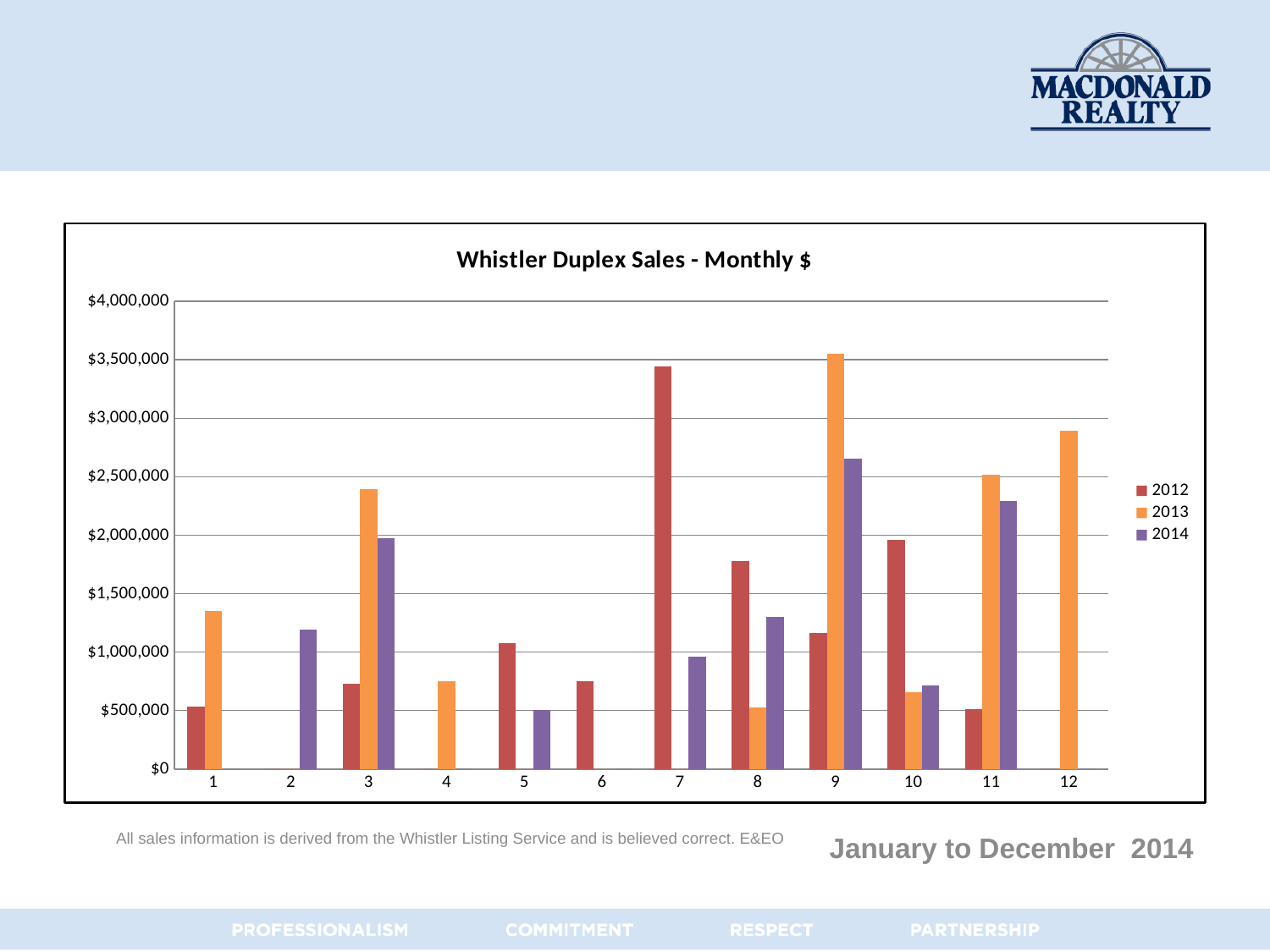
What is the title of the chart? Whistler Duplex Sales - Monthly $ Is the 2013 value for month 12 greater or less than $3,000,000? less How many months (categories) are shown on the x axis? 12 How many series does the legend list? 3 In month 3, which series has the larger value, 2013 or 2014? 2013 What kind of chart is shown on the slide? bar chart In month 9, which series has the larger value, 2012 or 2013? 2013 In which month does the 2014 series reach its highest value? 9 In which month does the 2012 series reach its highest value? 7 Is the 2012 value for month 7 greater or less than $3,000,000? greater In which month does the 2013 series reach its highest value? 9 Is the 2014 value for month 2 greater or less than $1,000,000? greater